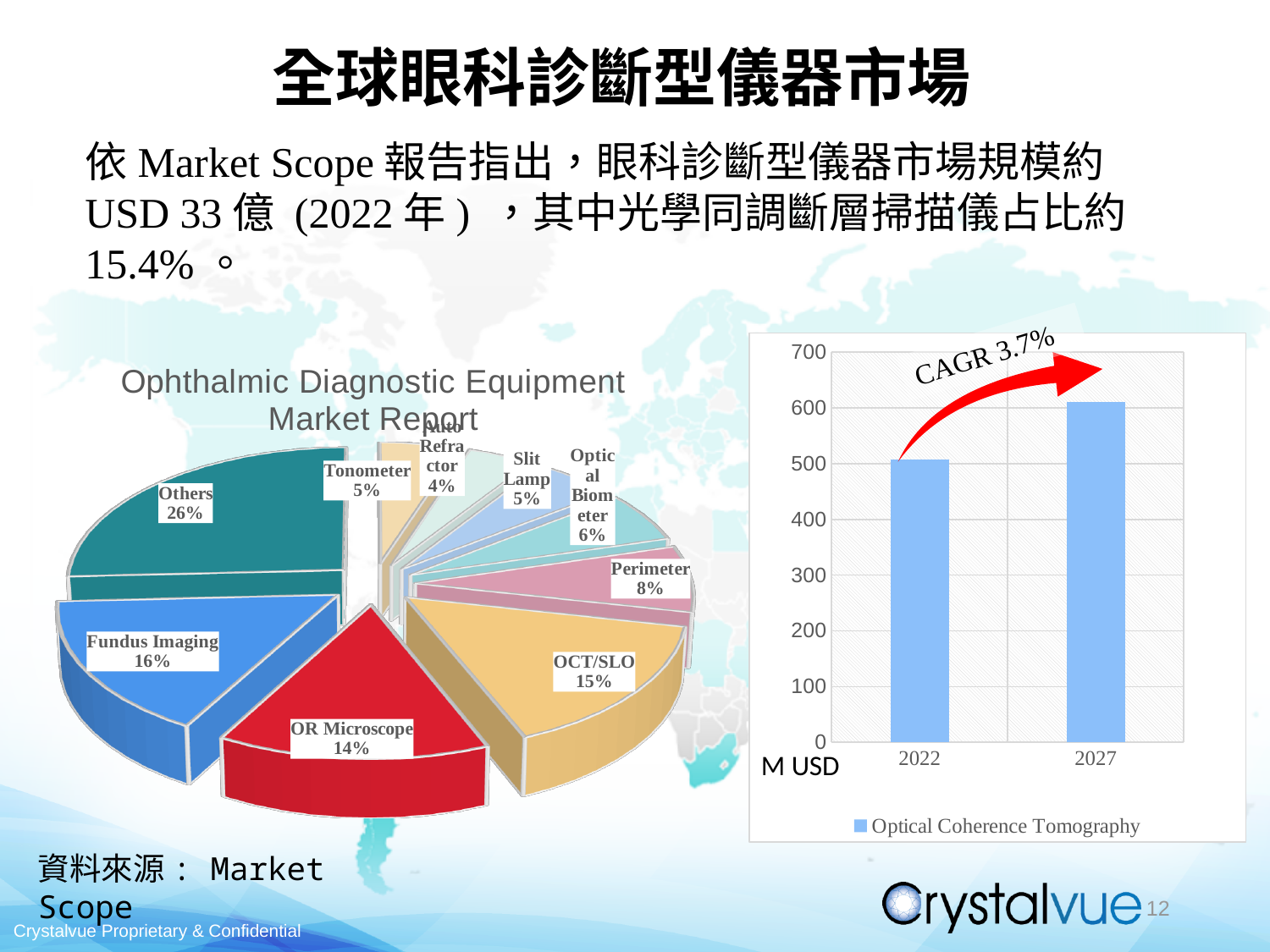
In the bar chart on the right, is the value for 2022 greater or less than 600? less What kind of chart is the chart on the right side of the slide showing 2022 and 2027? Bar chart In the pie chart titled 'Ophthalmic Diagnostic Equipment Market Report', what share does Perimeter hold? 8% In the pie chart titled 'Ophthalmic Diagnostic Equipment Market Report', what share does OCT/SLO hold? 15% How many slices does the pie chart titled 'Ophthalmic Diagnostic Equipment Market Report' have? 9 In the pie chart titled 'Ophthalmic Diagnostic Equipment Market Report', what is the difference in percentage points between Others and OR Microscope? 12 What series does the legend of the bar chart on the right list? Optical Coherence Tomography In the pie chart titled 'Ophthalmic Diagnostic Equipment Market Report', which slice is the largest? Others In the bar chart on the right, is the value for 2027 greater or less than 500? greater In the pie chart titled 'Ophthalmic Diagnostic Equipment Market Report', which slice is the smallest? Auto Refractor In the pie chart titled 'Ophthalmic Diagnostic Equipment Market Report', which has a larger share, Fundus Imaging or OCT/SLO? Fundus Imaging In the pie chart titled 'Ophthalmic Diagnostic Equipment Market Report', what share does Fundus Imaging hold? 16%